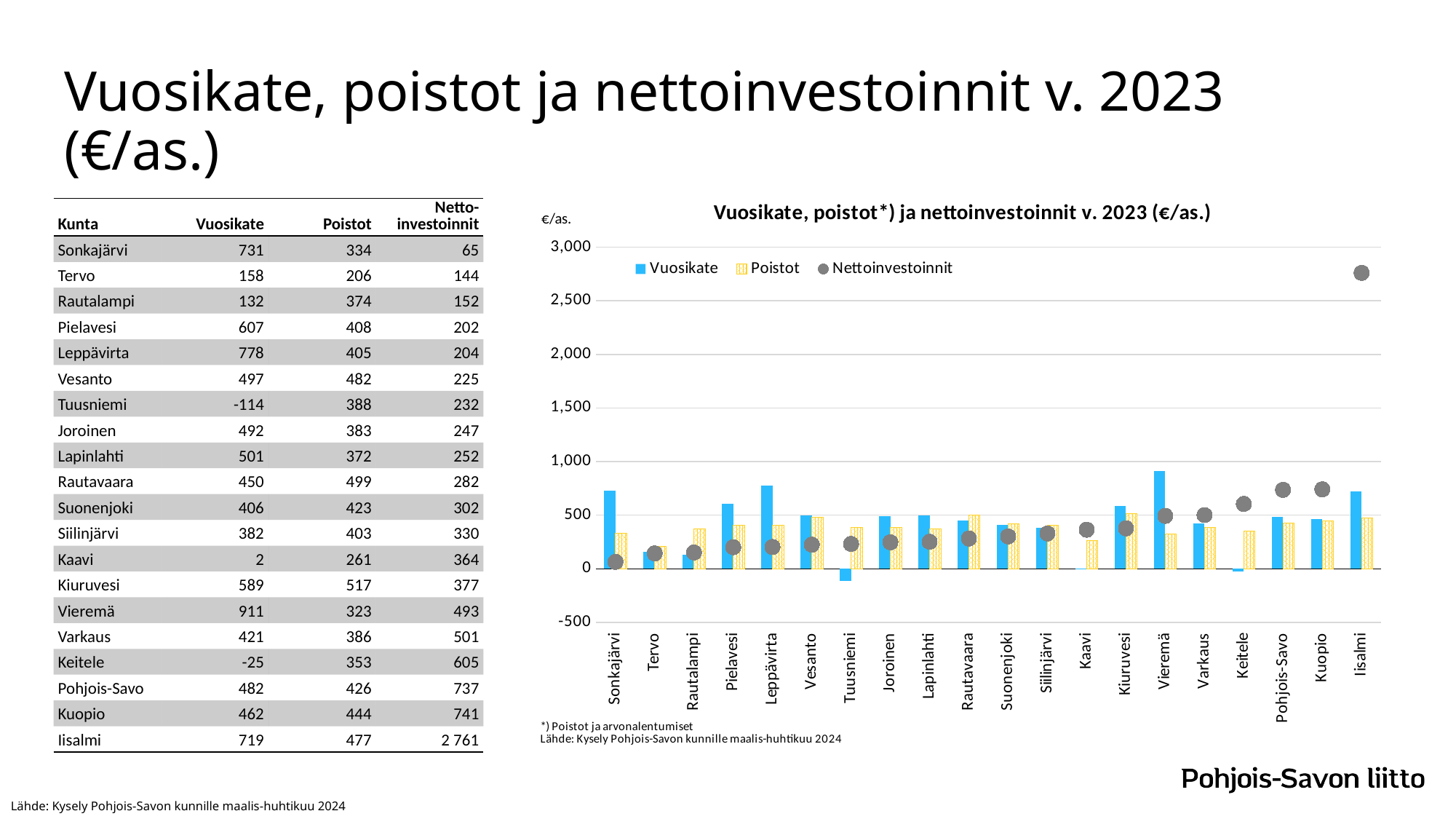
Do the Nettoinvestoinnit values generally rise or fall from left to right along the x axis? rise Which is larger, the Nettoinvestoinnit value for Keitele or for Varkaus? Keitele What kind of chart is shown on the slide? Bar chart (with dot markers for Nettoinvestoinnit) How many municipalities (categories) are plotted along the x axis of the chart? 20 What is the Vuosikate value for Sonkajärvi? 731 What is the difference between Vuosikate and Poistot for Sonkajärvi? 397 Is the Nettoinvestoinnit value for Iisalmi greater or less than 2,500? greater Which municipality has the lowest Vuosikate in the chart? Tuusniemi What is the Nettoinvestoinnit value for Iisalmi? 2 761 Which municipality has the highest Nettoinvestoinnit in the chart? Iisalmi Which municipality has the highest Vuosikate in the chart? Vieremä How many series does the chart legend list? 3